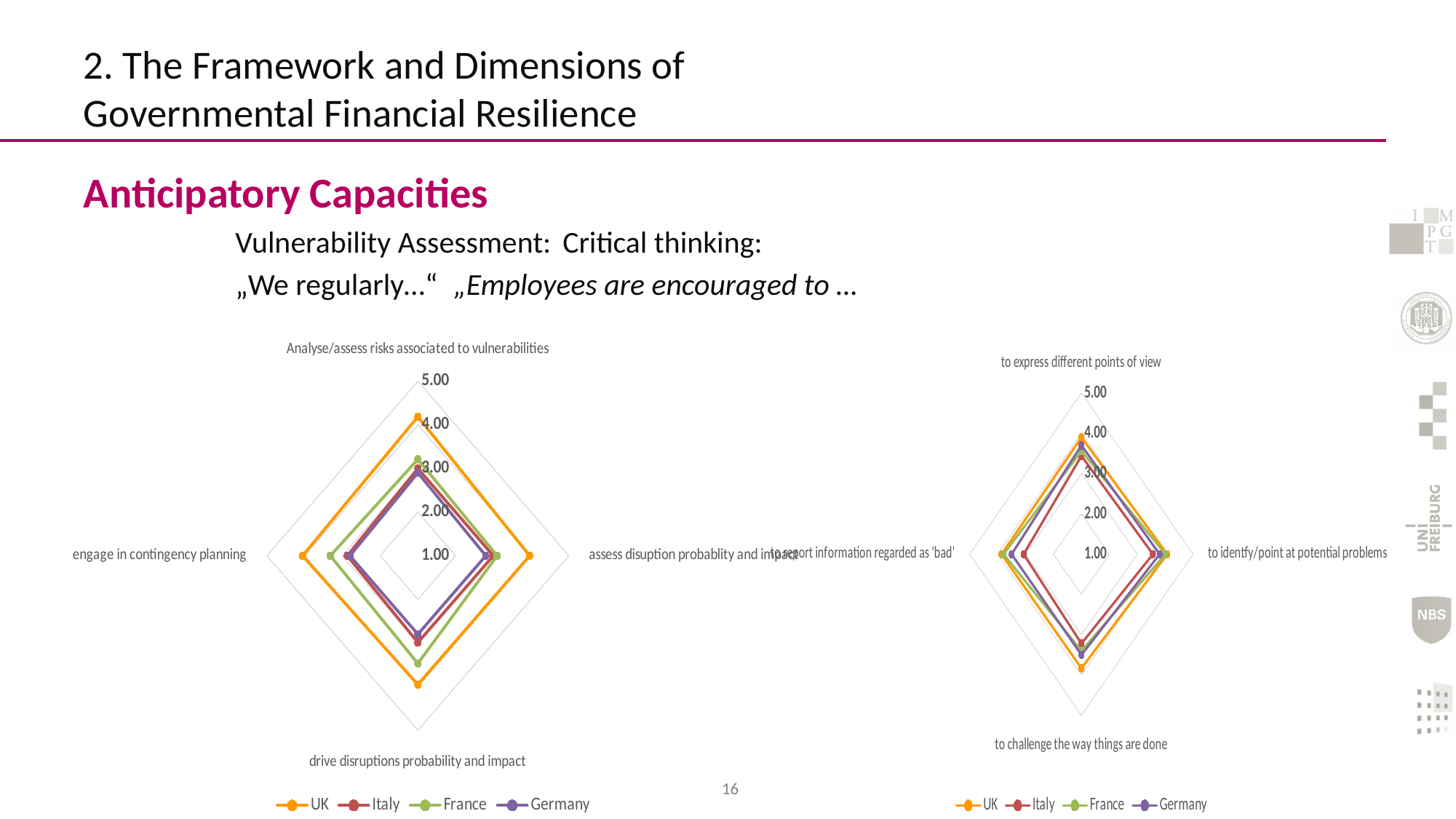
In the left chart (Vulnerability Assessment), which country has the highest value for 'drive disruptions probability and impact'? UK In the right chart (Critical thinking), which country has the highest value for 'to challenge the way things are done'? UK What kind of chart is the left chart (Vulnerability Assessment)? Radar chart In the right chart (Critical thinking), which country has the lowest value for 'to report information regarded as bad'? Italy How many series does the legend of the right chart (Critical thinking) list? 4 How many axes (categories) does the left chart (Vulnerability Assessment) have? 4 In the right chart (Critical thinking), which colour represents Germany in the legend? Purple In the left chart (Vulnerability Assessment), which is larger for 'engage in contingency planning': the value for UK or the value for Italy? UK In the left chart (Vulnerability Assessment), is the value for Germany on 'Analyse/assess risks associated to vulnerabilities' greater or less than 4.00? less In the left chart (Vulnerability Assessment), which country has the lowest value for 'drive disruptions probability and impact'? Germany In the left chart (Vulnerability Assessment), is the value for UK on 'engage in contingency planning' greater or less than 3.00? greater